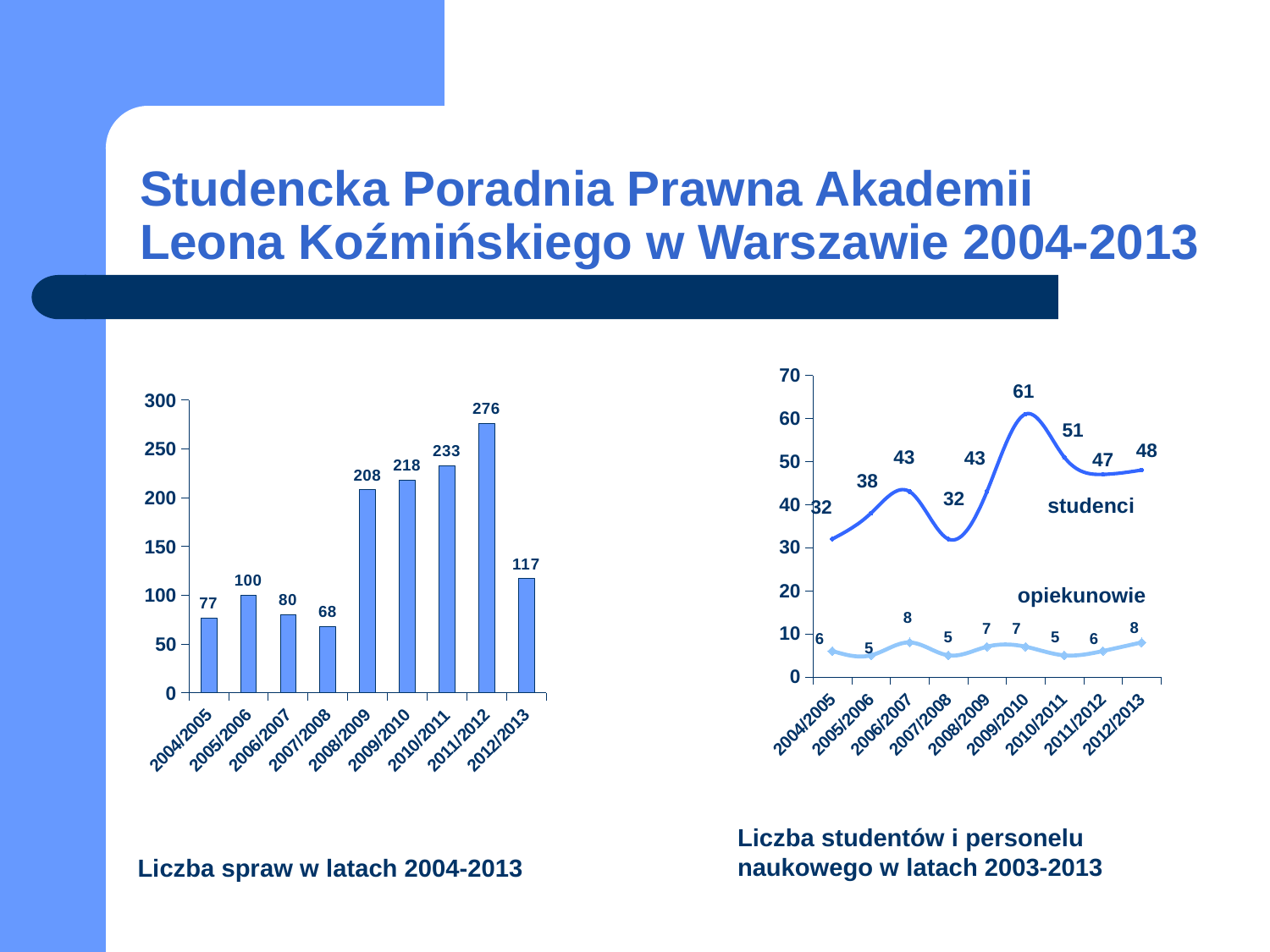
In the right line chart (Liczba studentów i personelu naukowego), is the value for studenci in 2011/2012 larger than the value for studenci in 2012/2013? No, 2012/2013 is larger (48 vs 47) In the left bar chart (Liczba spraw w latach 2004-2013), what is the value for 2008/2009? 208 What type of chart is the right chart (Liczba studentów i personelu naukowego)? line chart In the left bar chart (Liczba spraw w latach 2004-2013), which year has the highest value? 2011/2012 In the left bar chart (Liczba spraw w latach 2004-2013), what is the difference between the values for 2011/2012 and 2012/2013? 159 How many series are plotted in the right line chart (Liczba studentów i personelu naukowego)? 2 In the left bar chart (Liczba spraw w latach 2004-2013), how many years are shown on the x axis? 9 In the right line chart (Liczba studentów i personelu naukowego), what is the value for studenci in 2009/2010? 61 In the left bar chart (Liczba spraw w latach 2004-2013), which year has the lowest value? 2007/2008 In the right line chart (Liczba studentów i personelu naukowego), which year has the lowest value for studenci? 2004/2005 and 2007/2008 (both 32) In the right line chart (Liczba studentów i personelu naukowego), what is the value for opiekunowie in 2006/2007? 8 What type of chart is the left chart (Liczba spraw w latach 2004-2013)? bar chart